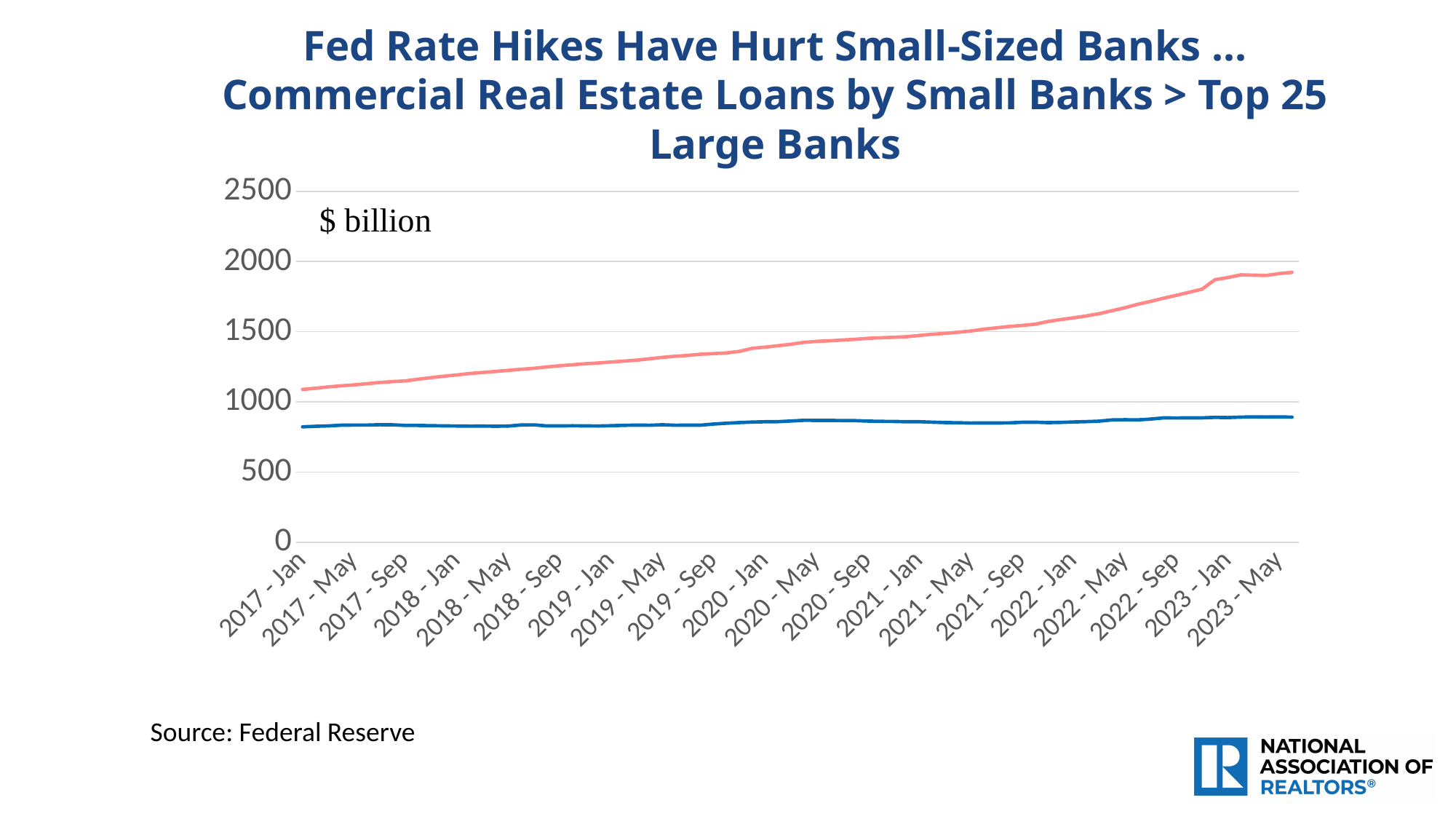
What unit is shown for the values on the chart? $ billion Is the value of the pink line at 2023 - May greater or less than 1500? greater Is the value of the blue line at 2023 - May greater or less than 1000? less How many lines are plotted on the chart? 2 Does the pink line rise or fall from 2017 - Jan to 2023 - May? Rise What type of chart is shown on the slide? Line chart Is the value of the pink line at 2023 - May greater or less than 2000? less How many date labels are shown along the x axis? 20 Which line is higher at 2023 - May, the pink line or the blue line? The pink line What is the highest value shown on the y axis? 2500